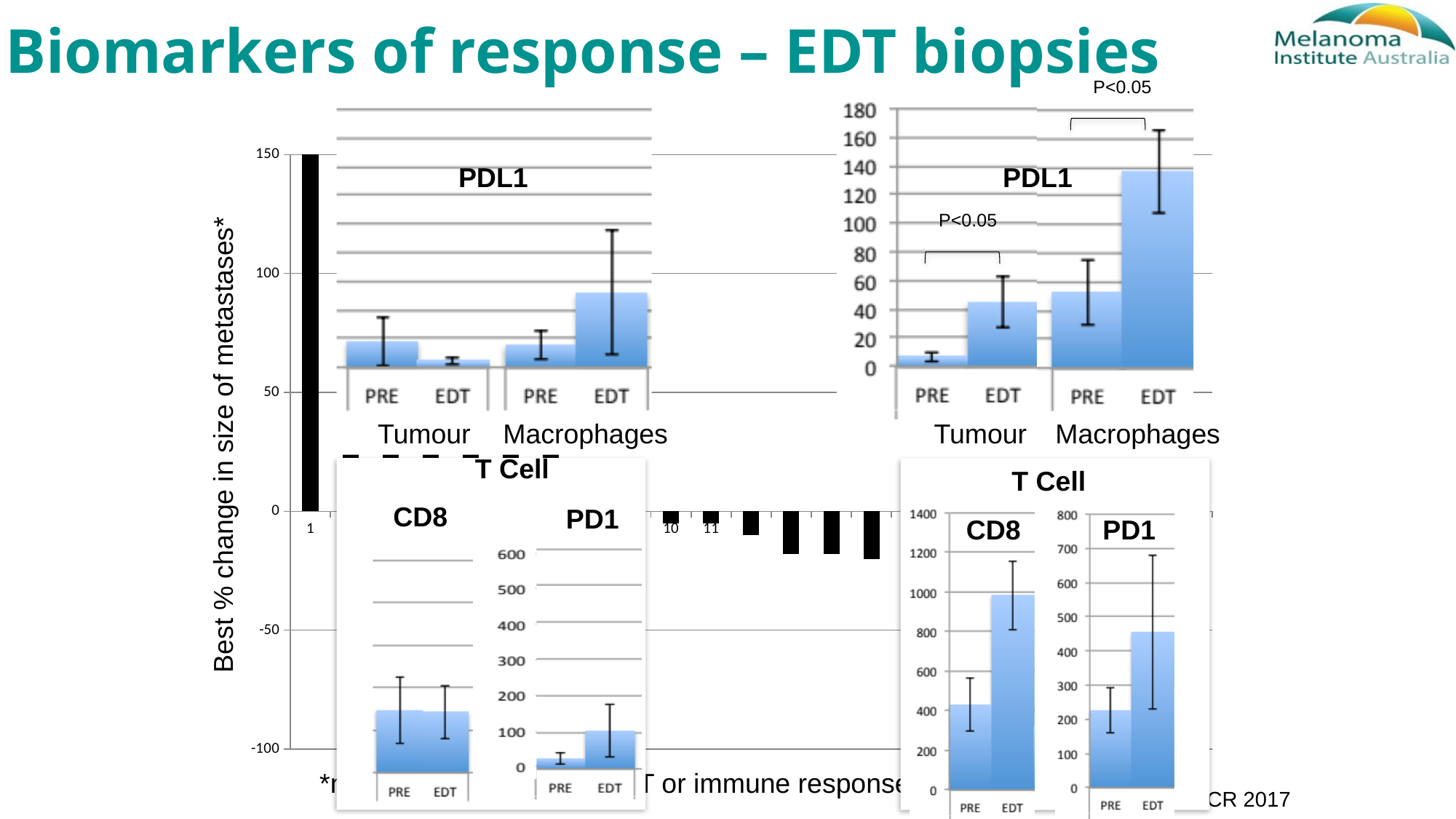
In the T Cell PD1 chart on the right, is the EDT value greater or less than 400? greater In the PDL1 chart on the right, which bar is the highest? Macrophages EDT In the T Cell PD1 chart on the right, is the PRE value greater or less than 300? less In the PDL1 chart on the right, is the Macrophages EDT value greater or less than 120? greater In the PDL1 chart on the right, for Tumour, which is larger: PRE or EDT? EDT What is the y-axis label of the large background bar chart on the slide? Best % change in size of metastases* In the T Cell CD8 chart on the right, which is larger: PRE or EDT? EDT What kind of chart is the PDL1 chart on the right side of the slide? bar chart In the PDL1 chart on the right, which bar is the lowest? Tumour PRE What p-value annotation is shown above the bars in the PDL1 chart on the right? P<0.05